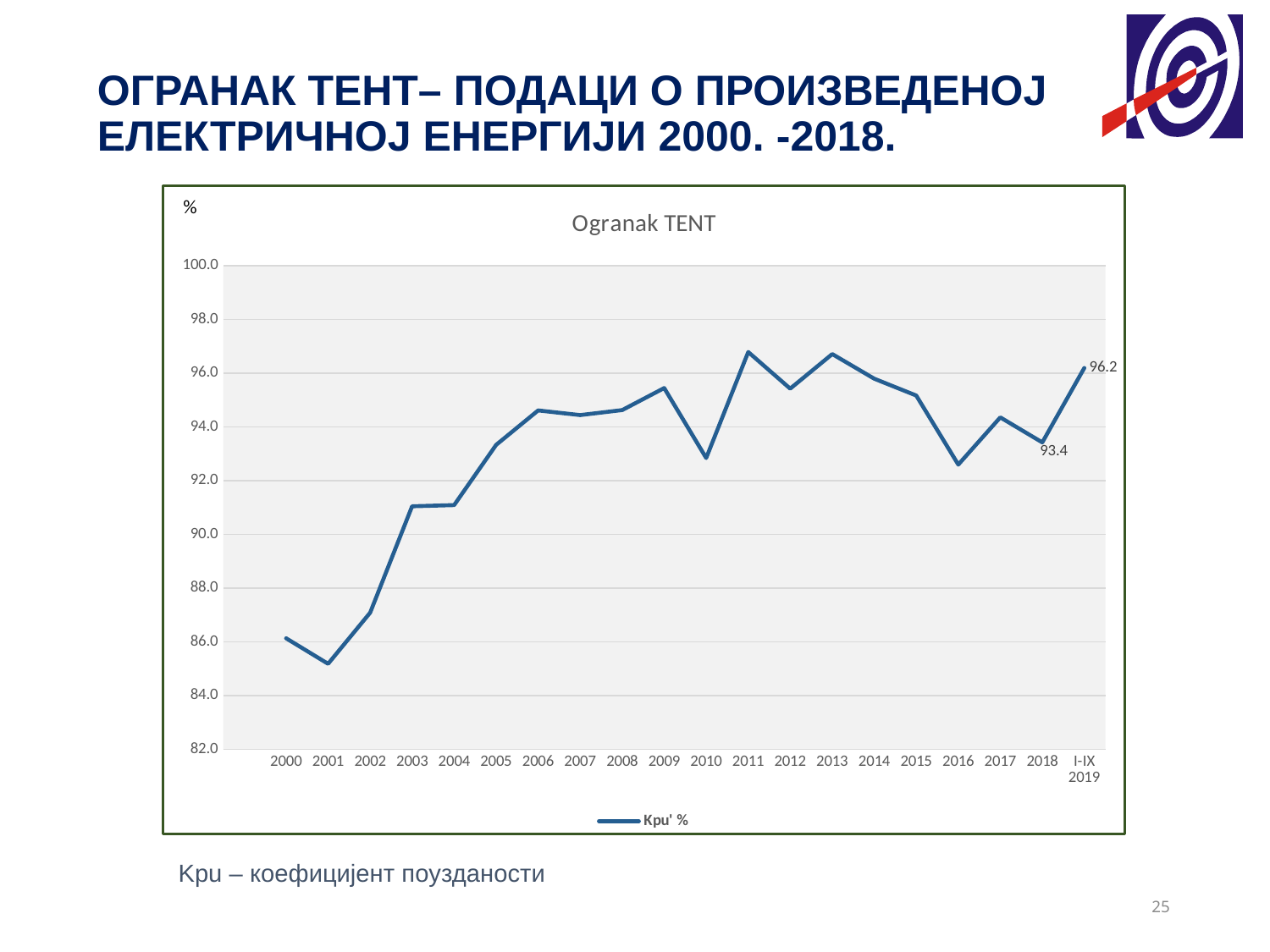
Which is larger, the Kpu' % value for 2010 or for 2011? 2011 What is the value of Kpu' % for 2018? 93.4 Is the value for 2000 greater or less than 88.0? less Which is larger, the Kpu' % value for 2001 or for 2002? 2002 What kind of chart is shown on the slide? line chart Is the value for 2016 greater or less than 94.0? less Is the value for 2003 greater or less than 90.0? greater How many data points are plotted on the x axis? 20 What is the difference between the Kpu' % values for I-IX 2019 and 2018? 2.8 Which year has the lowest Kpu' % value? 2001 Do the values rise or fall from 2013 to 2016? fall What is the value of Kpu' % for I-IX 2019? 96.2